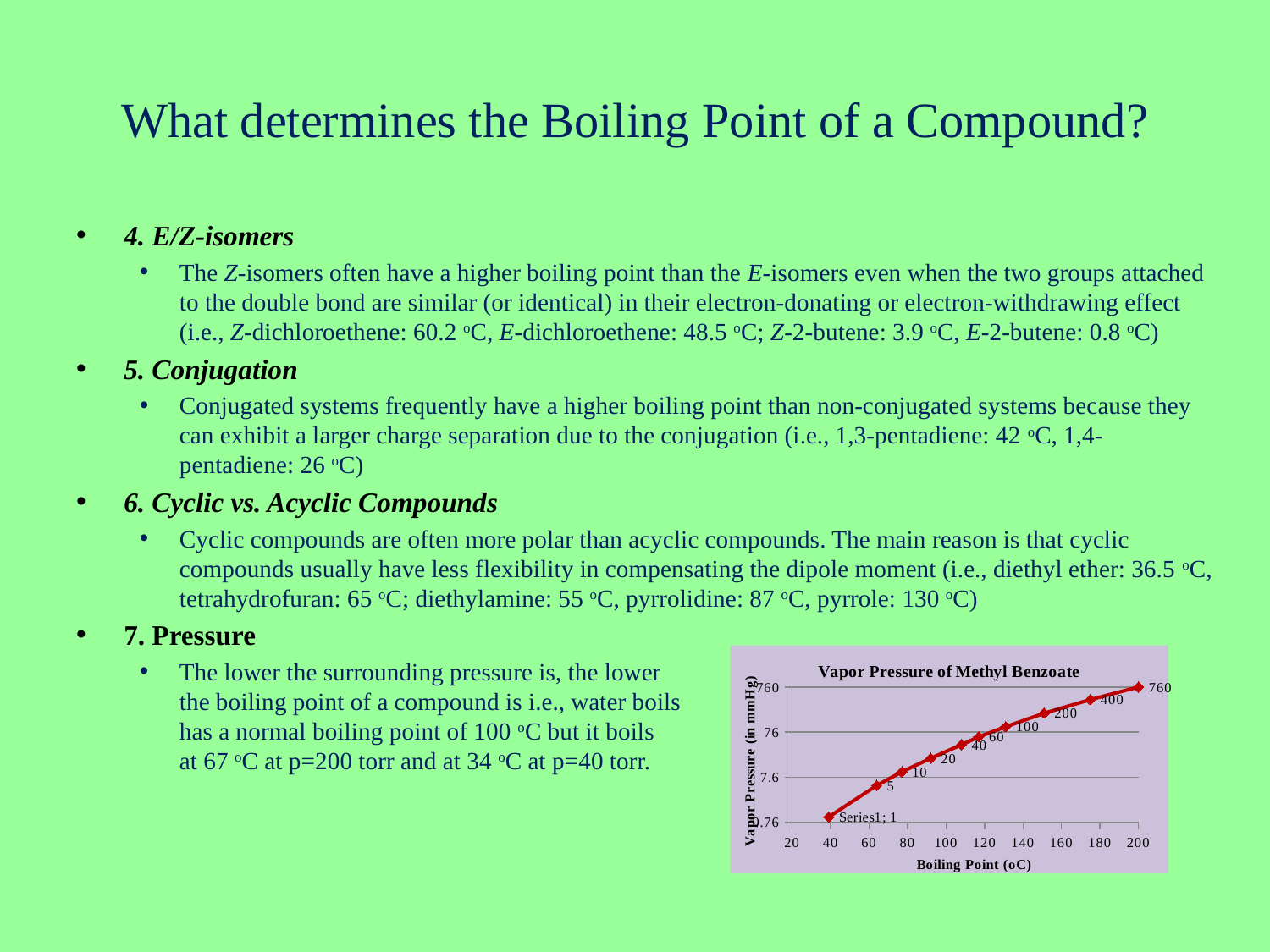
How many data points are plotted on the chart? 10 What kind of chart is shown on the slide? Line chart Is the boiling point of the point labeled 1 greater or less than 60? less What is the difference between the two highest labeled vapor pressure values, 760 and 400? 360 Does the vapor pressure rise or fall as the boiling point increases along the x axis? Rises What is the label of the x axis of the chart? Boiling Point (oC) What is the lowest vapor pressure value labeled on the chart? 1 What is the highest vapor pressure value labeled on the chart? 760 What is the title of the chart on the slide? Vapor Pressure of Methyl Benzoate What is the data label shown next to the first point on the chart? Series1; 1 Is the boiling point of the point labeled 760 greater or less than 180? greater Which labeled point has the larger vapor pressure, the one labeled 200 or the one labeled 100? 200